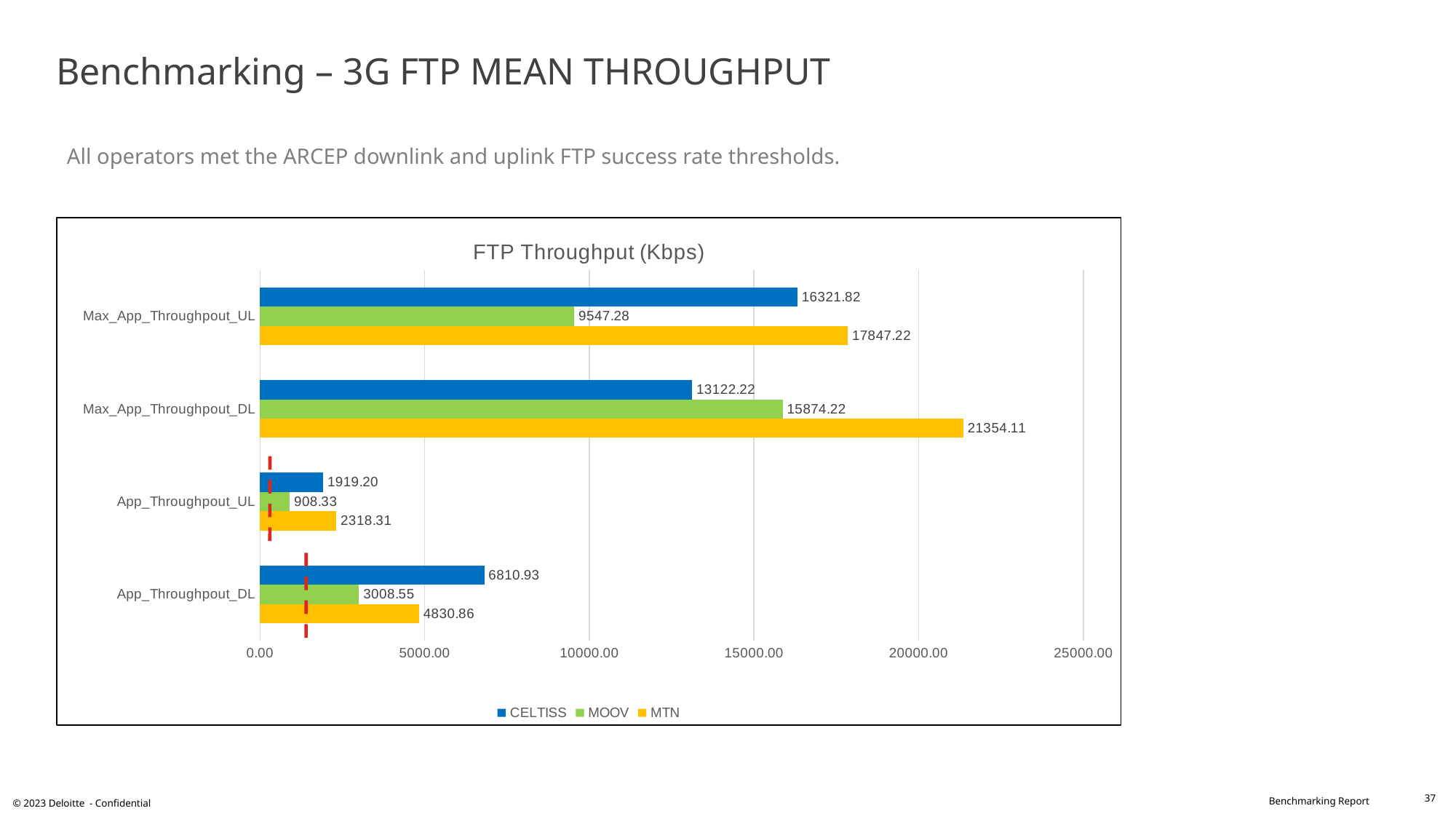
How many categories are shown on the y axis? 4 Which operator has the highest value for Max_App_Throughpout_DL? MTN Is the MOOV value for Max_App_Throughpout_DL greater or less than 15000.00? greater How many series does the legend list? 3 What is the MTN value for Max_App_Throughpout_UL? 17847.22 What is the MOOV value for App_Throughpout_UL? 908.33 Which operator has the lowest value for App_Throughpout_DL? MOOV What is the CELTISS value for App_Throughpout_DL? 6810.93 What is the difference between the MTN and CELTISS values for App_Throughpout_UL? 399.11 What is the MTN value for Max_App_Throughpout_DL? 21354.11 What type of chart is shown? Bar chart Which is larger for Max_App_Throughpout_UL: CELTISS or MOOV? CELTISS